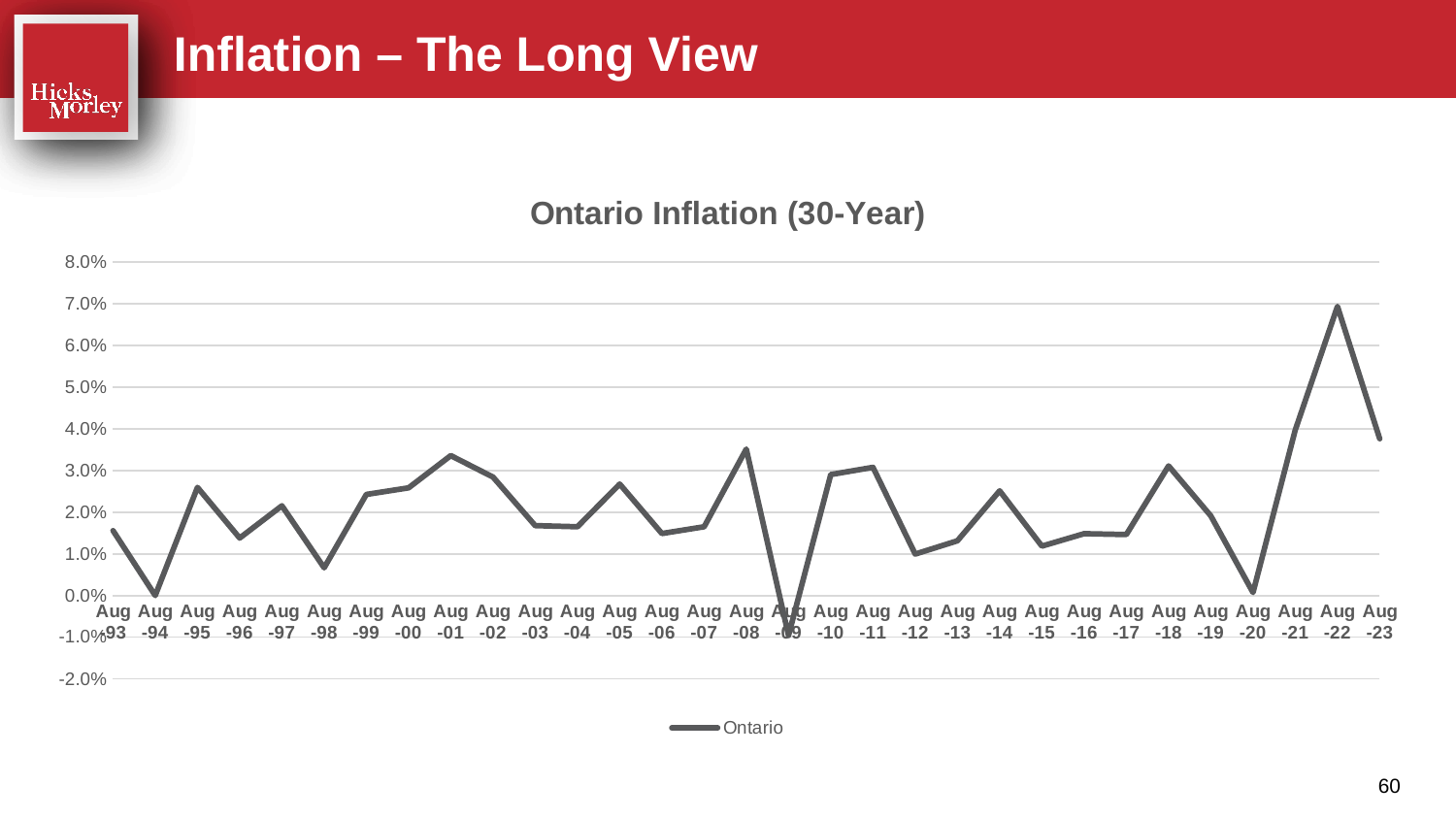
What is the title of the chart? Ontario Inflation (30-Year) Is the value for Aug-08 greater or less than 3.0%? greater Does the line rise or fall from Aug-20 to Aug-22? Rise Which year has the lowest inflation value? Aug-09 Is the value for Aug-09 greater or less than 0.0%? less What type of chart is shown on the slide? Line chart Is the value for Aug-12 greater or less than 2.0%? less How many data points are plotted along the x axis? 31 Which year has the highest inflation value? Aug-22 How many series does the legend list? 1 Which is larger, the value for Aug-22 or the value for Aug-23? Aug-22